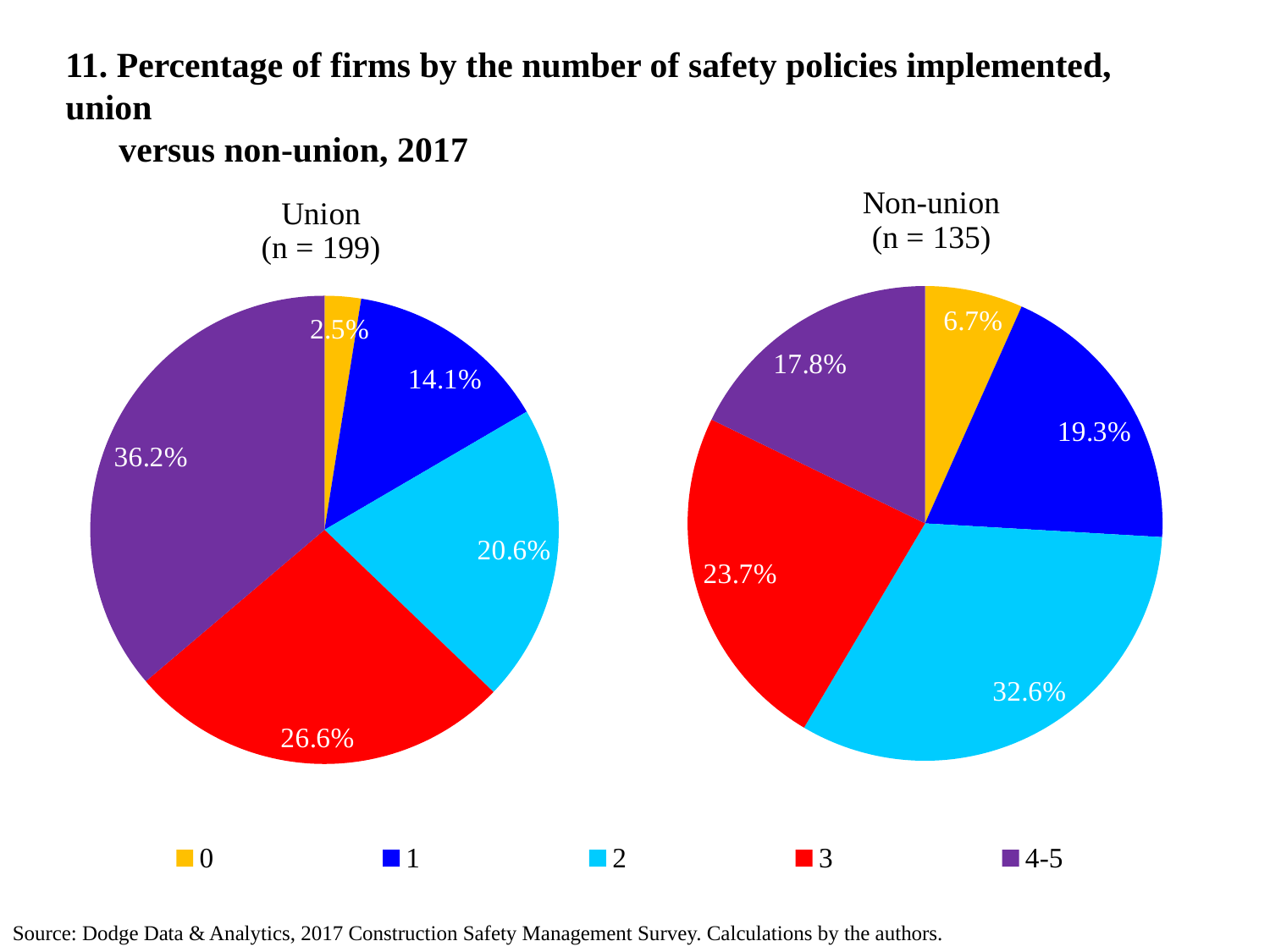
What is the difference between the Union and Non-union shares for firms with 4-5 safety policies? 18.4 percentage points What type of charts are shown on the slide? Pie charts In the Non-union pie chart, what percentage of firms implemented 2 safety policies? 32.6% In the Union pie chart, which category has the largest share? 4-5 How many categories does the legend list? 5 In the Non-union pie chart, which category has the largest share? 2 In the Union pie chart, which is larger: the share for 3 policies or the share for 2 policies? 3 What is the sample size (n) for the Non-union pie chart? 135 In the Union pie chart, what percentage of firms implemented 4-5 safety policies? 36.2% In the Non-union pie chart, what percentage of firms implemented 3 safety policies? 23.7% In the Union pie chart, what percentage of firms implemented 0 safety policies? 2.5% In the Non-union pie chart, which category has the smallest share? 0